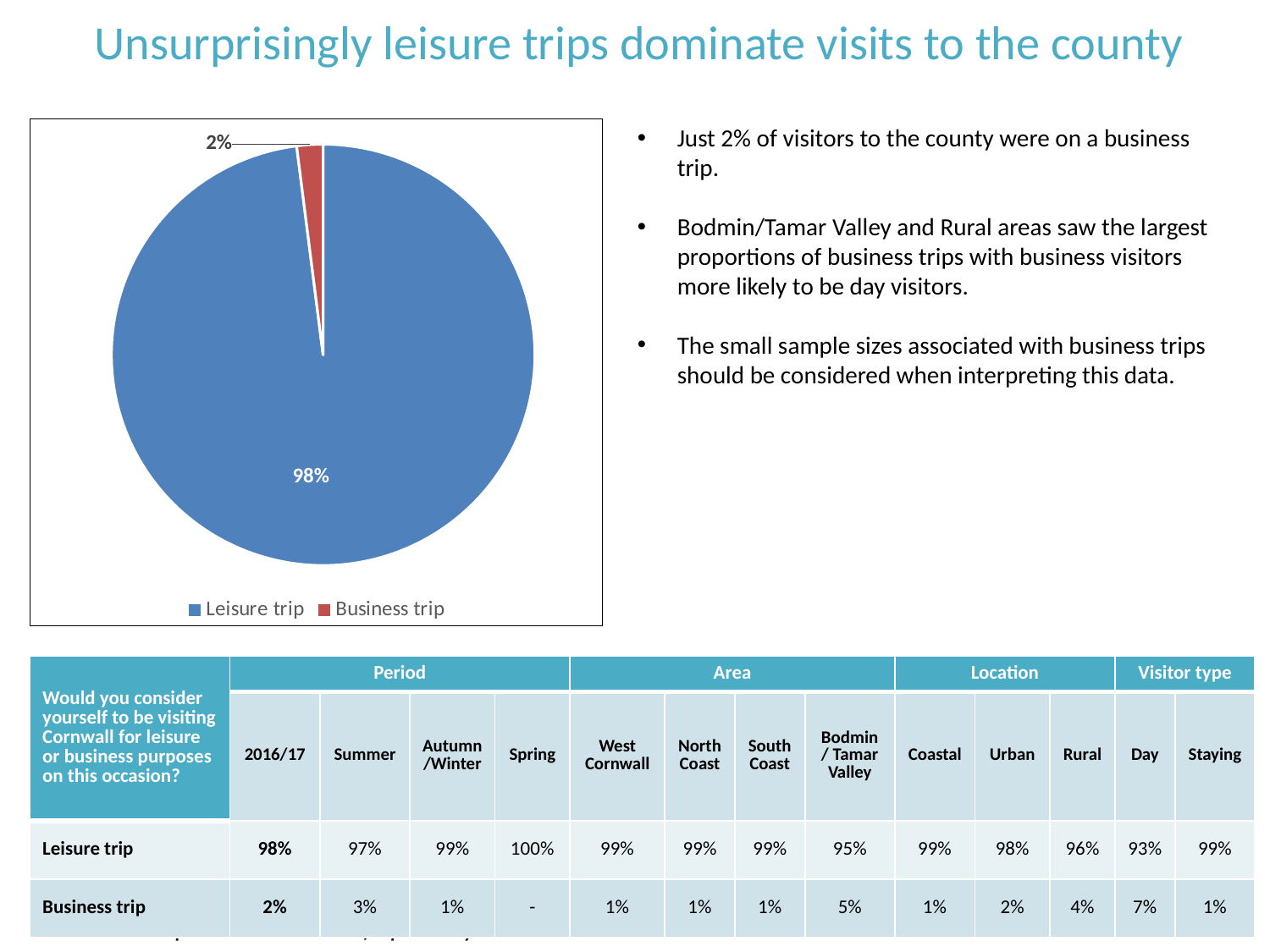
Which slice of the pie chart is the largest? Leisure trip Which is larger in the pie chart, Leisure trip or Business trip? Leisure trip How many slices does the pie chart have? 2 What kind of chart is shown on the slide? Pie chart What share of the pie is Business trip? 2% What share of the pie is Leisure trip? 98% What is the difference in percentage points between the Leisure trip and Business trip slices? 96 percentage points How many entries does the legend of the pie chart list? 2 Which slice of the pie chart is the smallest? Business trip What colour is the Business trip slice in the pie chart? Red What is the title of the slide containing the pie chart? Unsurprisingly leisure trips dominate visits to the county